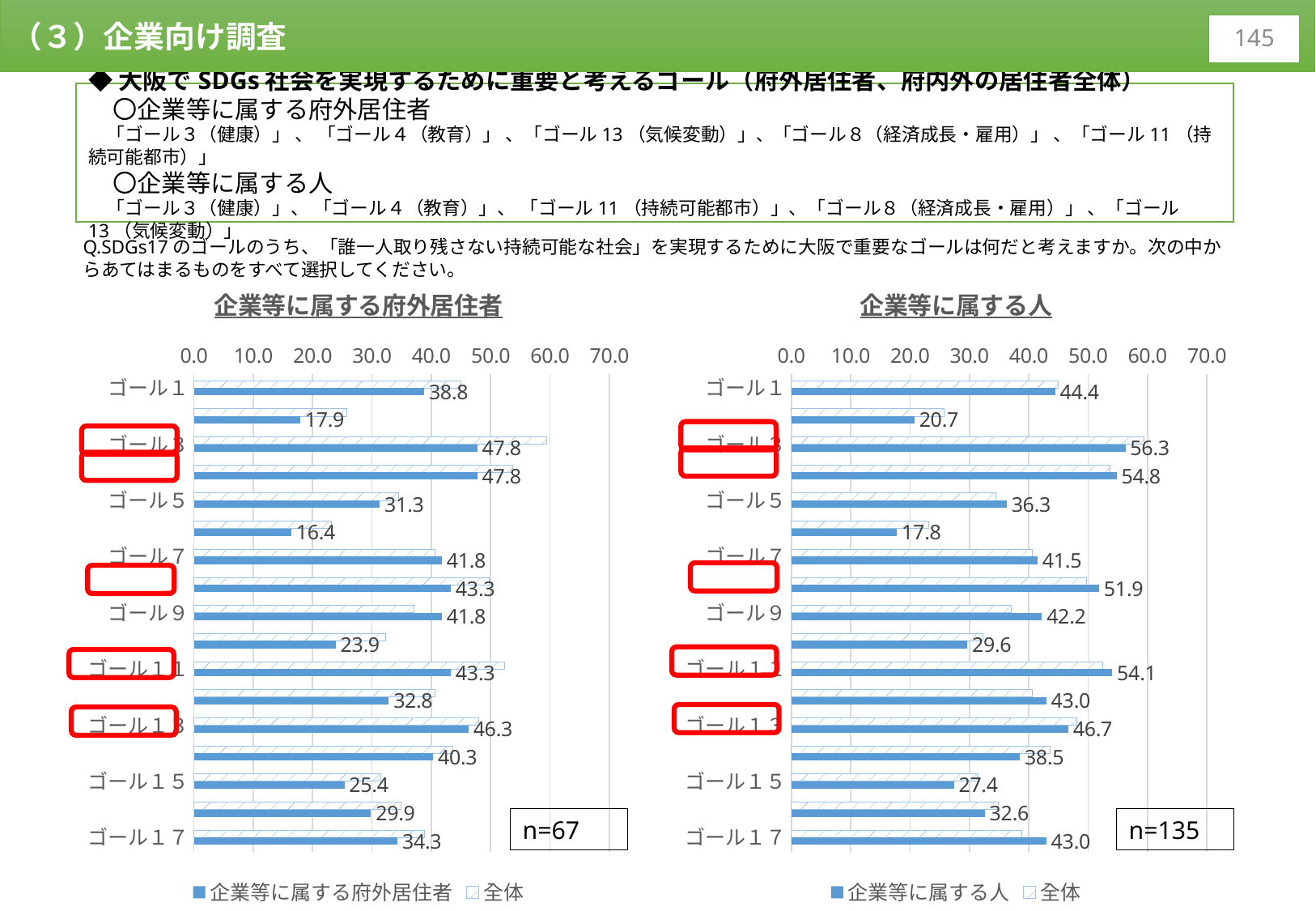
In the 企業等に属する府外居住者 chart, what is the value for ゴール1 for the 企業等に属する府外居住者 series? 38.8 In the 企業等に属する人 chart, is the 企業等に属する人 value for ゴール9 greater or less than 40.0? greater What sample size (n) is shown for the 企業等に属する府外居住者 chart? n=67 In the 企業等に属する府外居住者 chart, what is the difference between the 企業等に属する府外居住者 values for ゴール1 and ゴール17? 4.5 In the 企業等に属する人 chart, what is the difference between the 企業等に属する人 values for ゴール11 and ゴール13? 7.4 In the 企業等に属する府外居住者 chart, what is the value for ゴール13 for the 企業等に属する府外居住者 series? 46.3 In the 企業等に属する府外居住者 chart, which has the larger 企業等に属する府外居住者 value, ゴール5 or ゴール9? ゴール9 How many goal categories are plotted in the 企業等に属する人 chart? 17 In the 企業等に属する人 chart, what is the value for ゴール11 for the 企業等に属する人 series? 54.1 In the 企業等に属する人 chart, what is the value for ゴール1 for the 企業等に属する人 series? 44.4 How many series does the legend of the 企業等に属する府外居住者 chart list? 2 What kind of chart is used on this slide for 企業等に属する府外居住者? bar chart